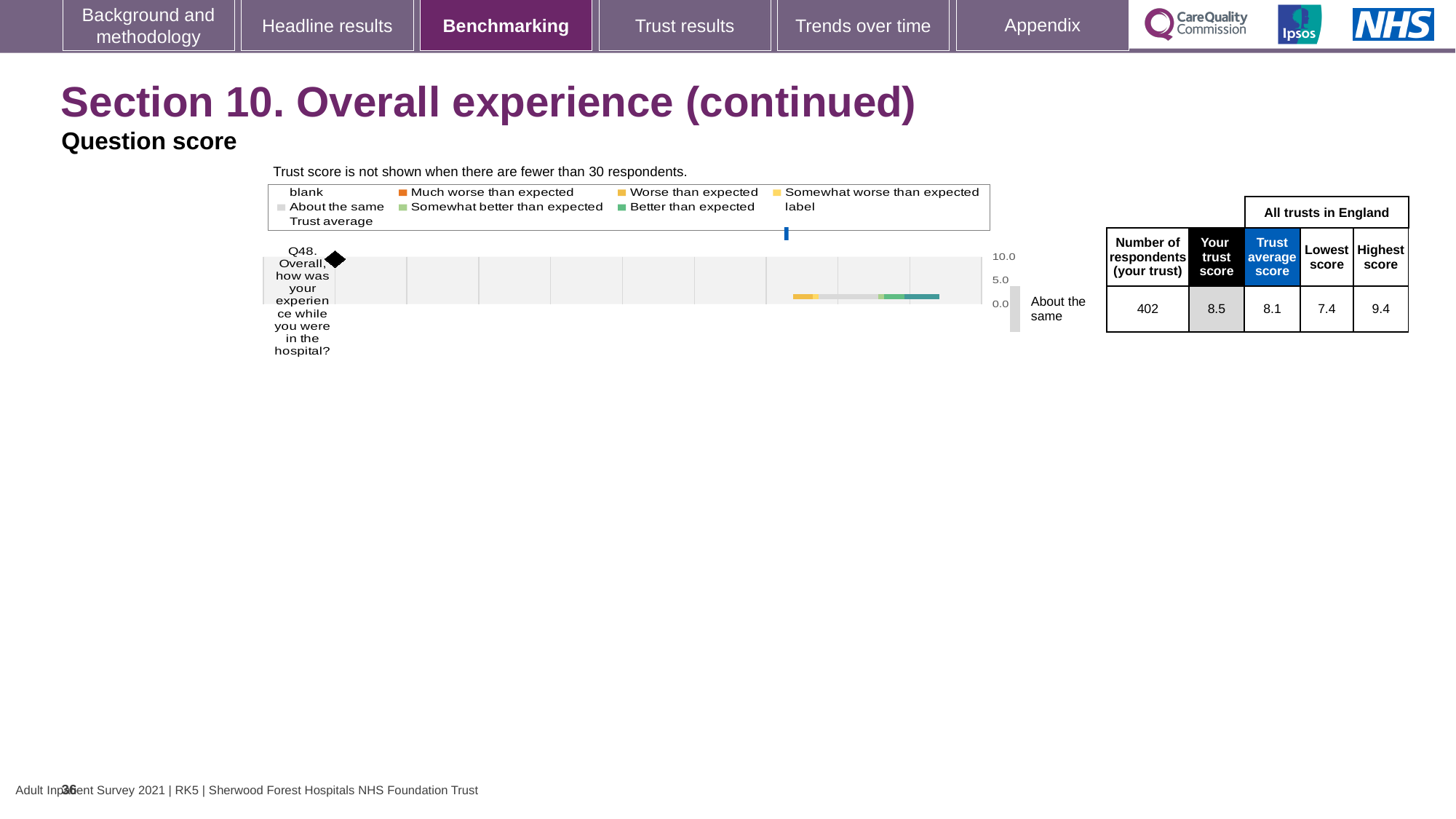
What kind of chart is used to show the Q48 question score? bar chart What is the trust score for Q48 shown in the table beside the chart? 8.5 What is the trust average score for Q48 across all trusts in England? 8.1 Which question is plotted in the chart? Q48. Overall, how was your experience while you were in the hospital? What is the difference between the highest score and the lowest score for Q48 among all trusts in England? 2.0 What benchmark category label is shown next to the chart for Q48? About the same What is the lowest score for Q48 among all trusts in England? 7.4 How many respondents from the trust answered Q48? 402 How many questions (categories) are plotted in the chart? 1 Is the trust score for Q48 larger or smaller than the trust average score? larger What is the highest value shown on the chart's axis? 10.0 What is the highest score for Q48 among all trusts in England? 9.4